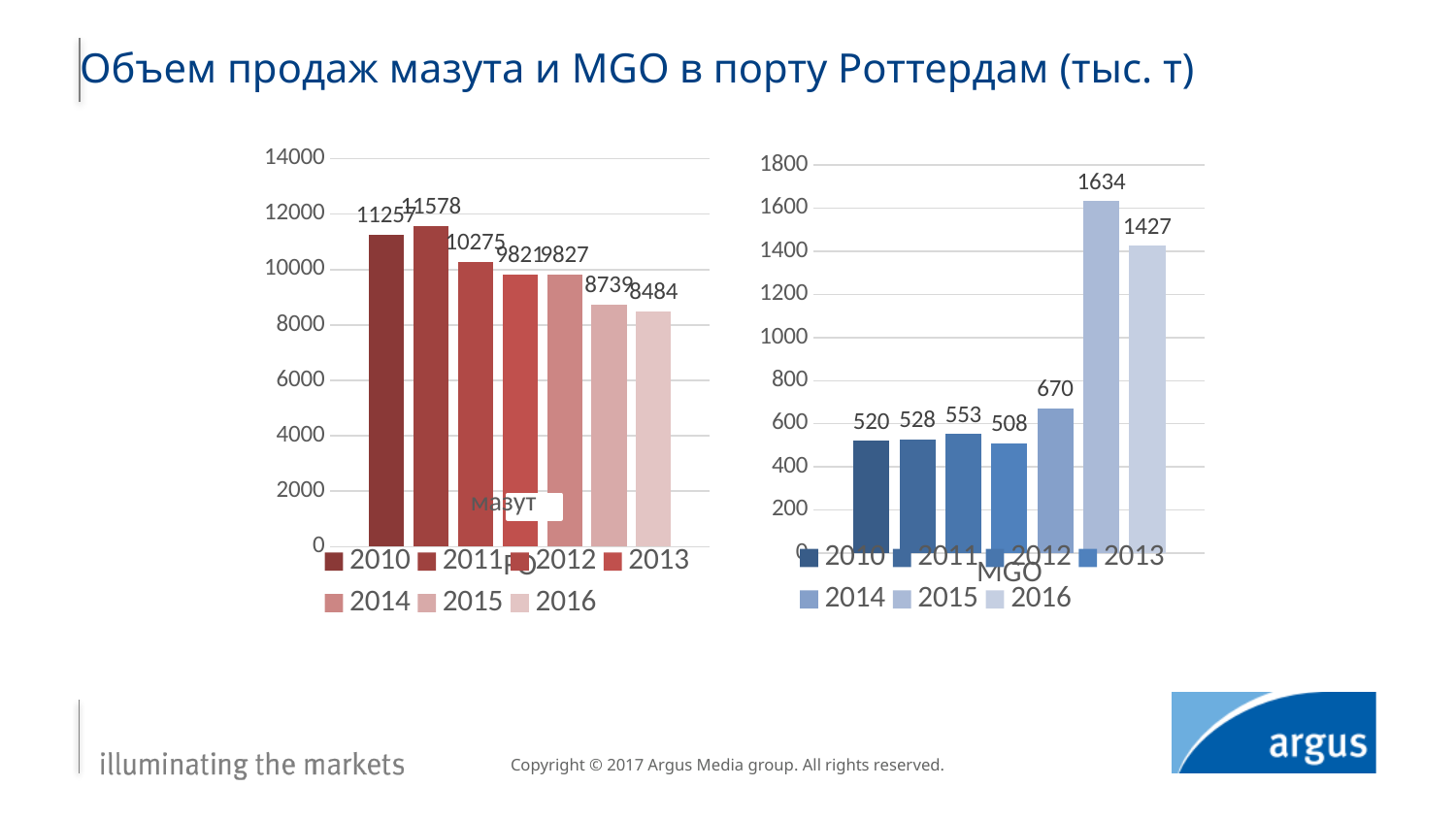
On the MGO chart (right), what is the difference between the 2015 and 2016 values? 207 On the мазут chart (left), what is the value for 2012? 10275 On the MGO chart (right), what is the value for 2014? 670 How many bars are shown on the MGO chart (right)? 7 On the MGO chart (right), which year has the highest value? 2015 On the мазут chart (left), what is the difference between the 2015 and 2016 values? 255 On the MGO chart (right), what is the value for 2015? 1634 On the MGO chart (right), which is larger, the value for 2012 or the value for 2014? 2014 What type of chart is the мазут chart (left)? bar chart On the мазут chart (left), which year has the lowest value? 2016 On the MGO chart (right), what is the value for 2016? 1427 On the мазут chart (left), what is the value for 2016? 8484